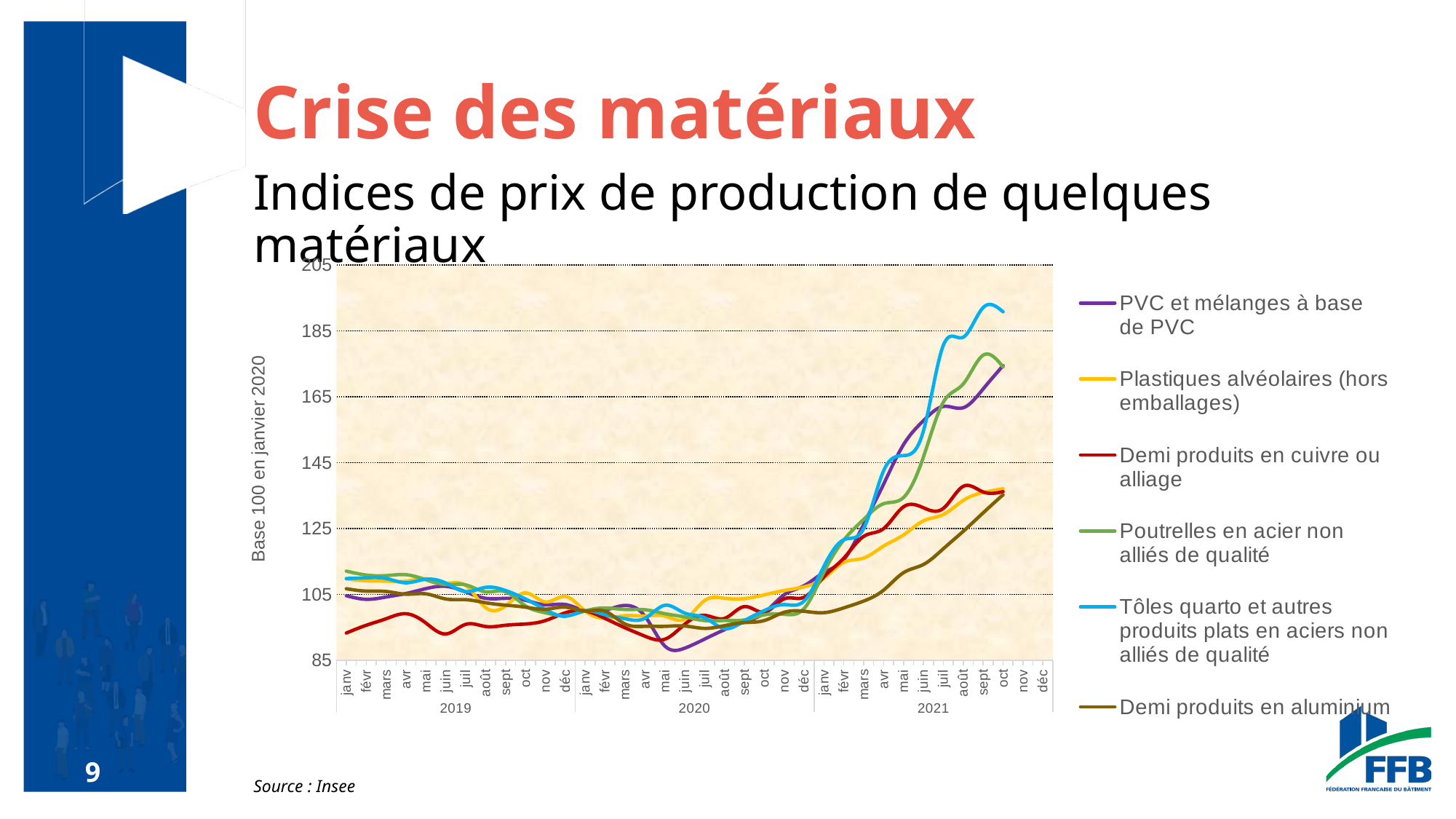
Is the value for Tôles quarto et autres produits plats en aciers non alliés de qualité in sept 2021 greater or less than 185? greater Is the value for Demi produits en cuivre ou alliage in mai 2020 greater or less than 105? less How many series does the legend list? 6 Is the value for PVC et mélanges à base de PVC in oct 2021 greater or less than 165? greater In oct 2021, which is larger: Tôles quarto et autres produits plats en aciers non alliés de qualité or Demi produits en aluminium? Tôles quarto et autres produits plats en aciers non alliés de qualité What kind of chart is shown on the slide? line chart How many years are labelled along the x axis of the chart? 3 What is the label of the vertical axis of the chart? Base 100 en janvier 2020 Which series has the lowest value in mai 2020? PVC et mélanges à base de PVC Which series reaches the highest value on the chart in 2021? Tôles quarto et autres produits plats en aciers non alliés de qualité Do the values for Tôles quarto et autres produits plats en aciers non alliés de qualité rise or fall from janv 2021 to sept 2021? rise